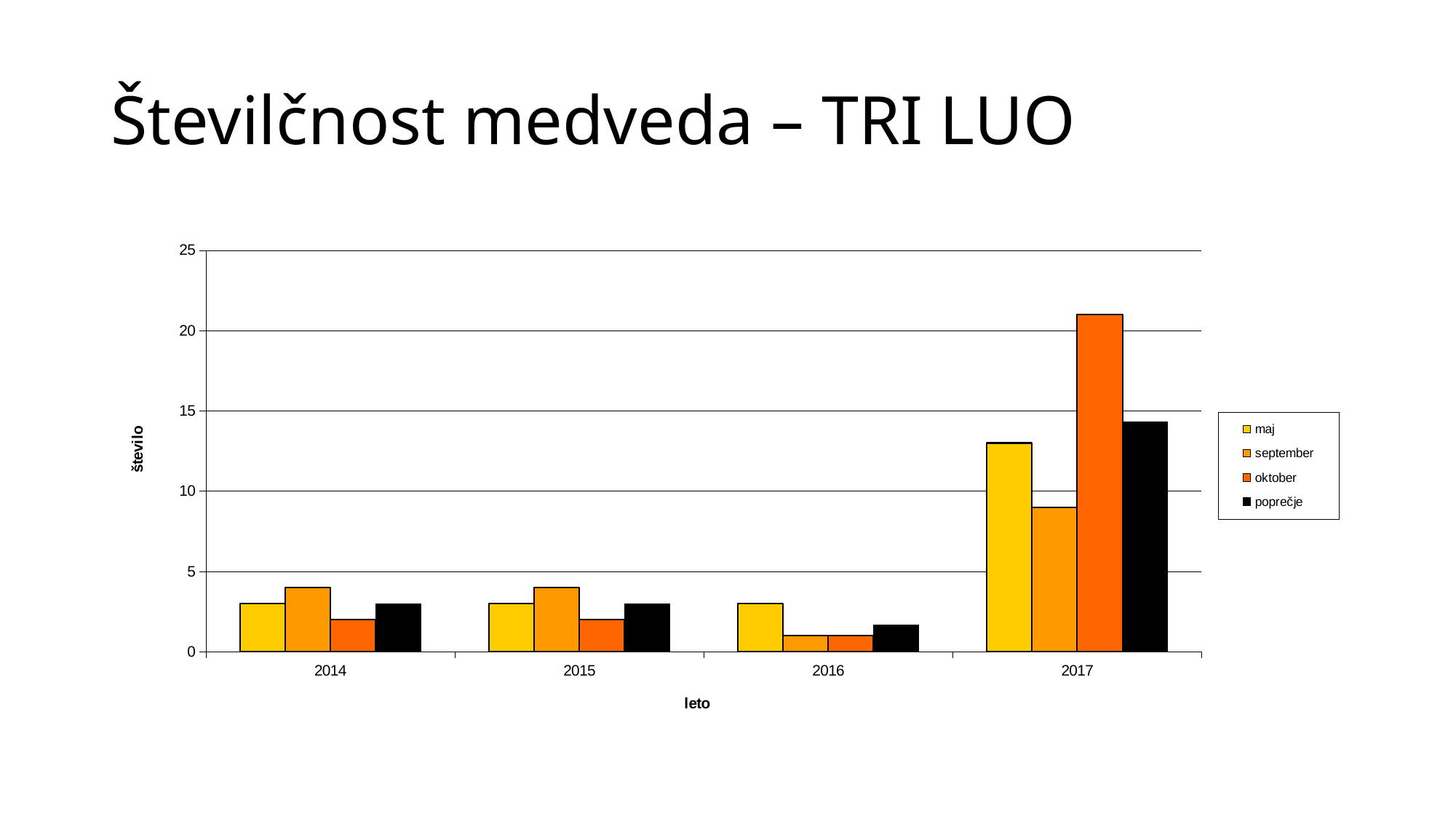
Which is larger in 2014, the september value or the oktober value? september In which year is the oktober value highest? 2017 How many years are shown on the x axis? 4 Is the value for maj in 2017 greater or less than 15? less What is the title of the y axis? število Is the value for september in 2017 greater or less than 10? less Is the value for oktober in 2017 greater or less than 20? greater What kind of chart is shown on the slide? bar chart Which series has the highest value in 2017? oktober How many series does the legend list? 4 Which is larger in 2017, the maj value or the september value? maj